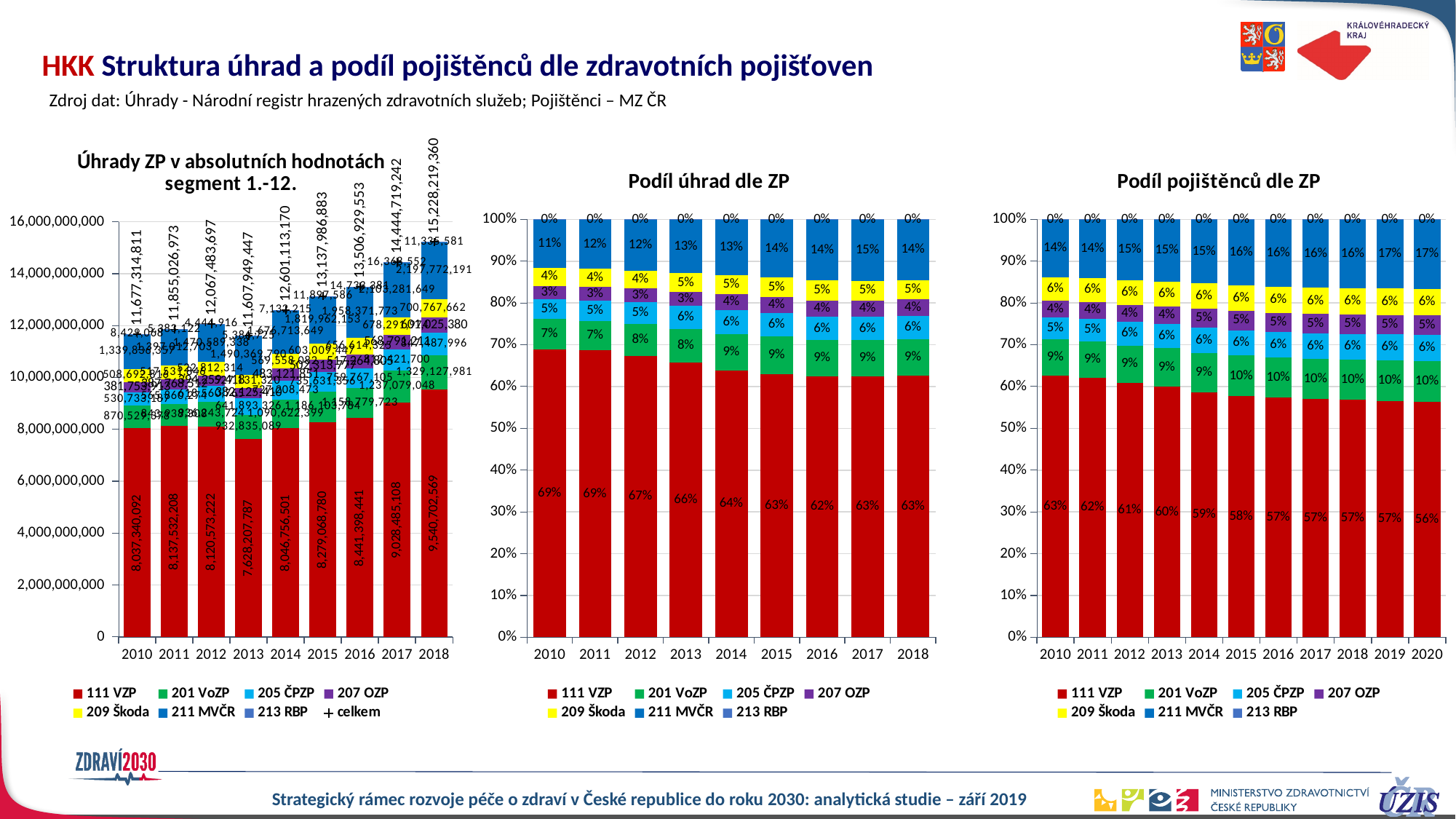
In the chart 'Podíl úhrad dle ZP', what is the share of 211 MVČR in 2017? 15% In the chart 'Podíl pojištěnců dle ZP', how many years are shown on the x axis? 11 How many series does the legend of the chart 'Podíl pojištěnců dle ZP' list? 7 In the chart 'Úhrady ZP v absolutních hodnotách segment 1.-12.', what is the total (celkem) value for 2018? 15,228,219,360 In the chart 'Úhrady ZP v absolutních hodnotách segment 1.-12.', what is the value for 111 VZP in 2013? 7,628,207,787 In the chart 'Úhrady ZP v absolutních hodnotách segment 1.-12.', how many years are shown on the x axis? 9 In the chart 'Úhrady ZP v absolutních hodnotách segment 1.-12.', what is the difference between the 111 VZP values for 2018 and 2017? 512,217,461 In the chart 'Podíl pojištěnců dle ZP', what is the share of 111 VZP in 2020? 56% In the chart 'Podíl úhrad dle ZP', does the share of 111 VZP generally rise or fall from 2010 to 2018? fall In the chart 'Úhrady ZP v absolutních hodnotách segment 1.-12.', which year has the lowest total (celkem) value? 2013 In the chart 'Podíl úhrad dle ZP', what is the share of 111 VZP in 2010? 69% In the chart 'Podíl pojištěnců dle ZP', which is larger in 2019: the share of 211 MVČR or the share of 201 VoZP? 211 MVČR